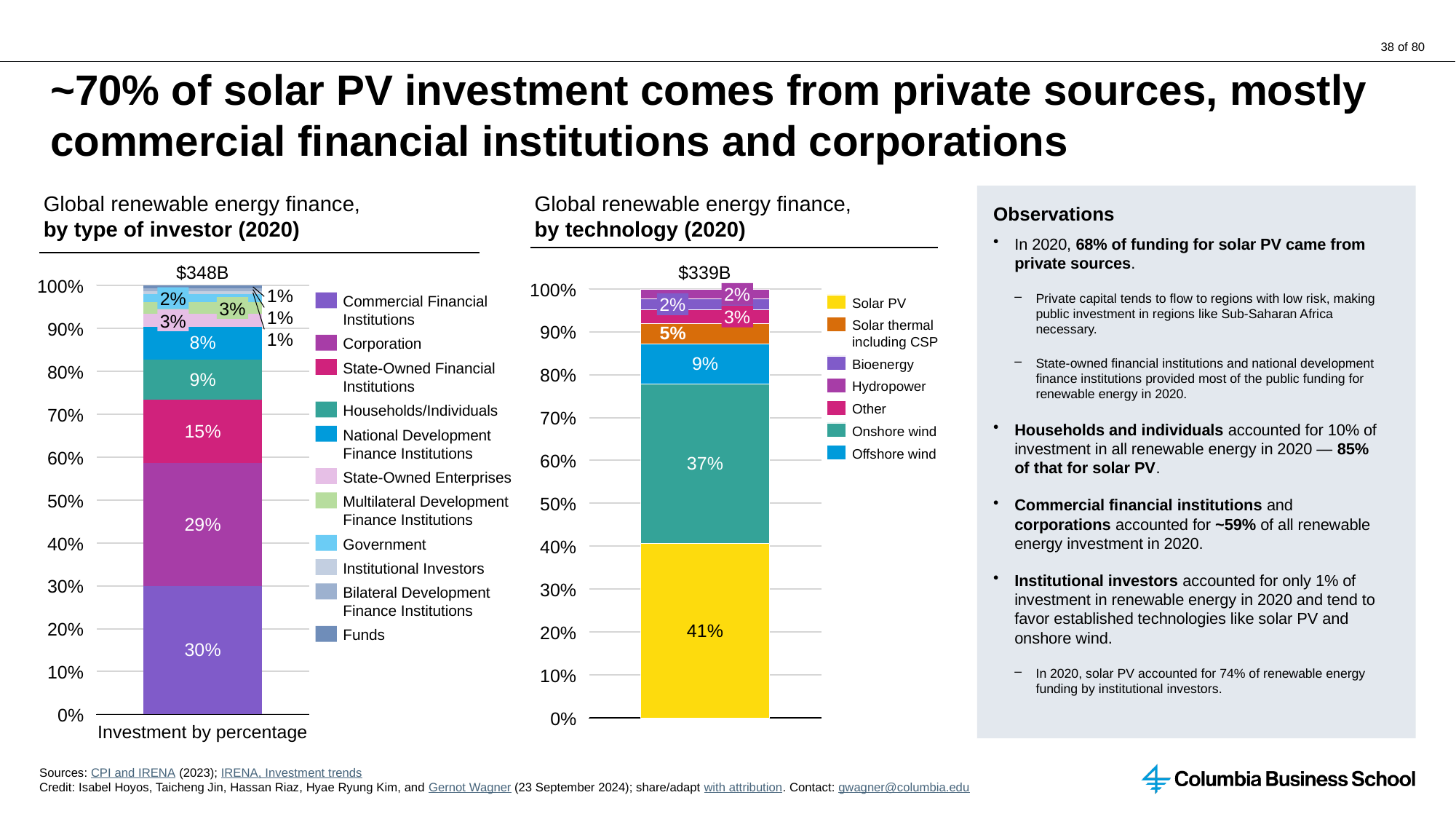
In the chart 'Global renewable energy finance, by technology (2020)', which technology has the largest share? Solar PV How many technologies does the legend of the chart 'Global renewable energy finance, by technology (2020)' list? 7 In the chart 'Global renewable energy finance, by type of investor (2020)', what percentage is attributed to Commercial Financial Institutions? 30% In the chart 'Global renewable energy finance, by type of investor (2020)', what total dollar amount is shown above the bar? $348B How many investor types does the legend of the chart 'Global renewable energy finance, by type of investor (2020)' list? 11 What kind of chart is used for 'Global renewable energy finance, by technology (2020)'? Stacked bar chart In the chart 'Global renewable energy finance, by type of investor (2020)', what is the difference in percentage points between State-Owned Financial Institutions and Households/Individuals? 6 percentage points In the chart 'Global renewable energy finance, by technology (2020)', what percentage is attributed to Solar PV? 41% In the chart 'Global renewable energy finance, by type of investor (2020)', what percentage is attributed to Corporation? 29% In the chart 'Global renewable energy finance, by technology (2020)', which is larger: Offshore wind or Solar thermal including CSP? Offshore wind In the chart 'Global renewable energy finance, by technology (2020)', what percentage is attributed to Onshore wind? 37% In the chart 'Global renewable energy finance, by type of investor (2020)', which investor type has the largest share? Commercial Financial Institutions